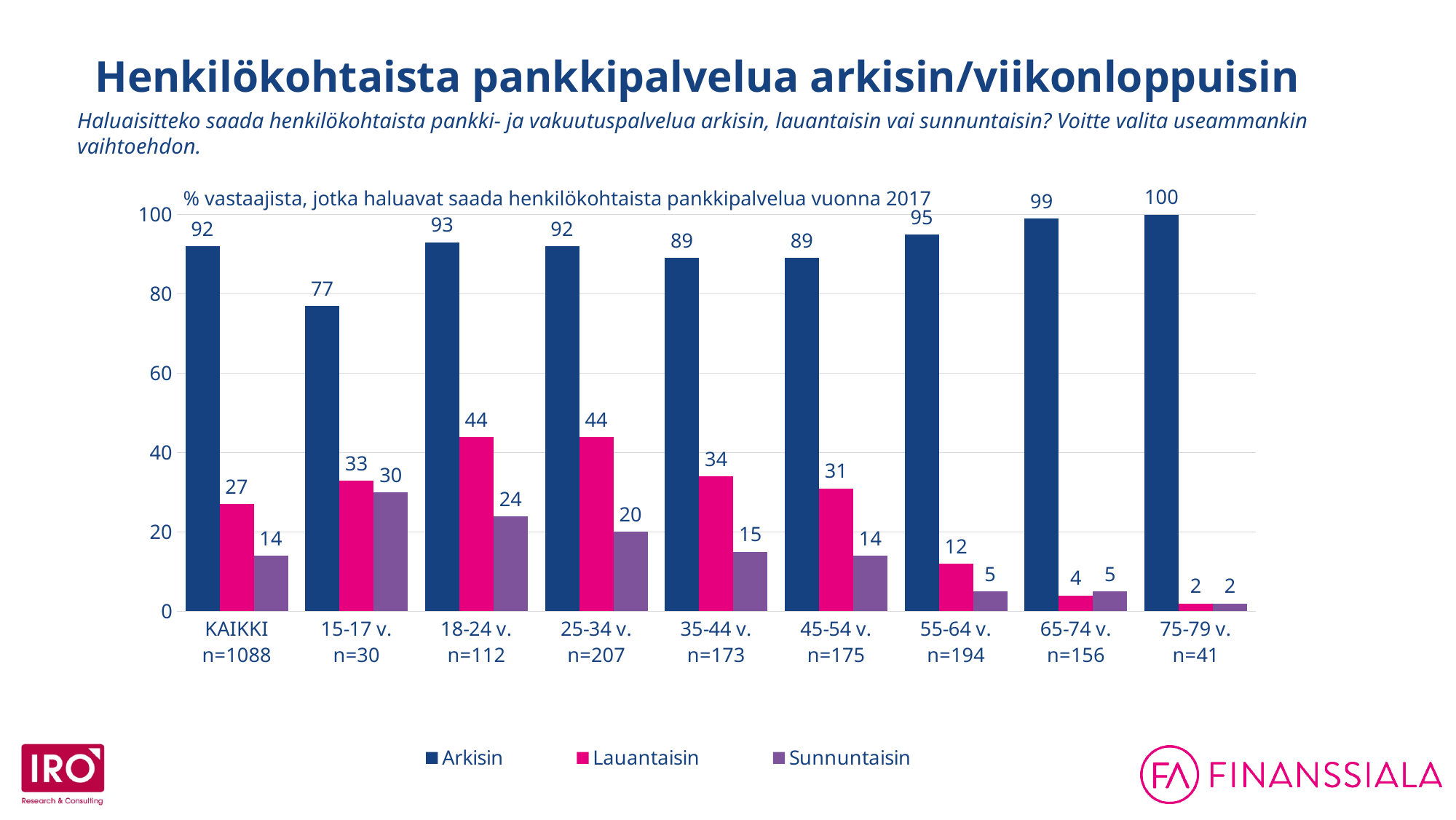
How many categories are shown on the x axis? 9 What is the Arkisin value for the 15-17 v. group? 77 Which age group has the highest Arkisin value? 75-79 v. What is the Lauantaisin value for the 35-44 v. group? 34 Which is larger for the 65-74 v. group: Lauantaisin or Sunnuntaisin? Sunnuntaisin What colour are the Lauantaisin bars? Pink Which age group has the lowest Arkisin value? 15-17 v. What kind of chart is shown on the slide? Bar chart How many series does the legend list? 3 Does the Lauantaisin value rise or fall from the 25-34 v. group to the 75-79 v. group? Fall What is the Sunnuntaisin value for the KAIKKI group? 14 What is the difference between the Lauantaisin and Sunnuntaisin values for the 18-24 v. group? 20